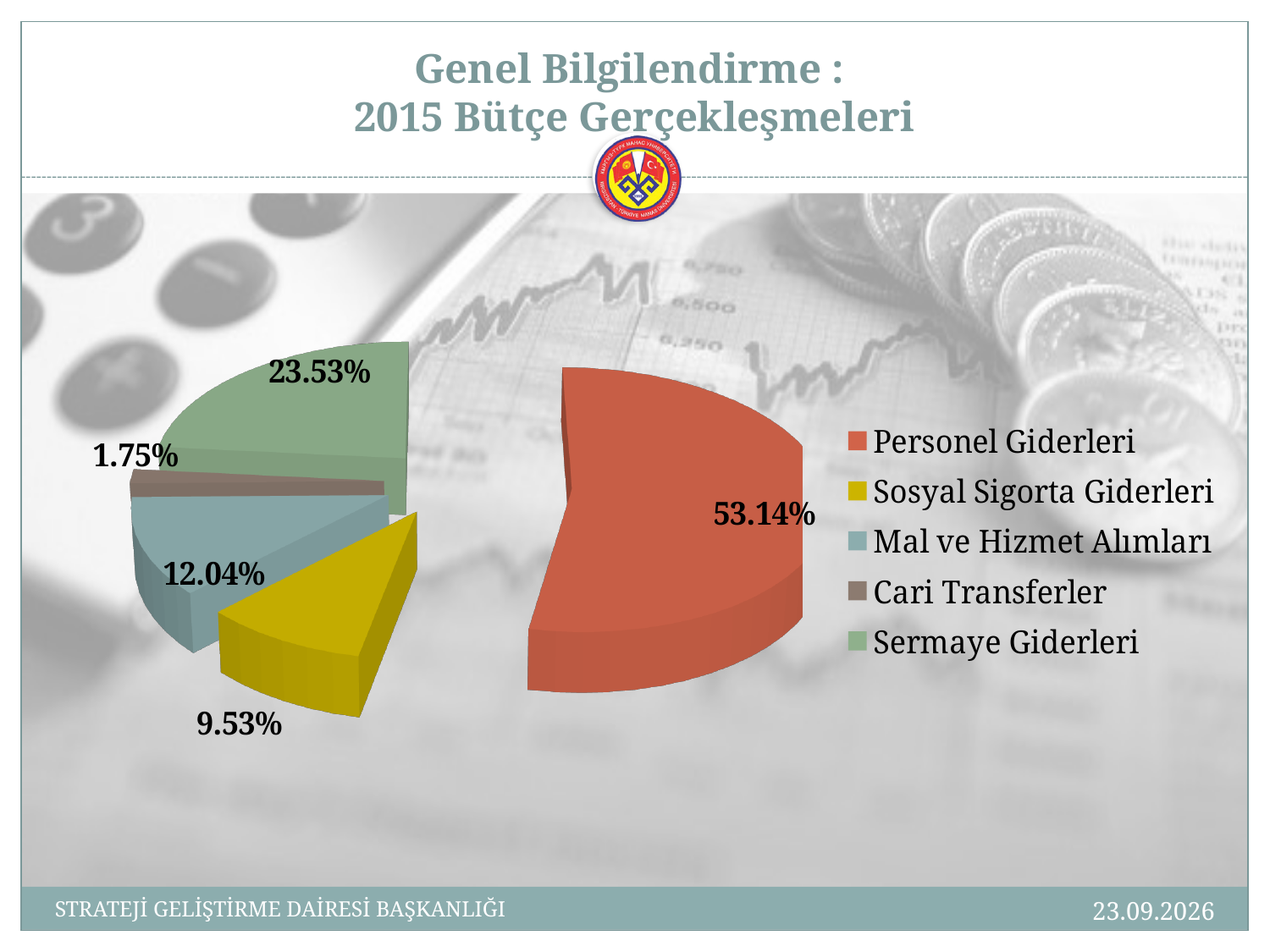
Which category has the smallest share of the pie? Cari Transferler Which is larger, the share for Mal ve Hizmet Alımları or the share for Sosyal Sigorta Giderleri? Mal ve Hizmet Alımları What is the share for Cari Transferler? 1.75% What is the share for Sosyal Sigorta Giderleri? 9.53% What kind of chart is shown on the slide? Pie chart What is the share for Personel Giderleri? 53.14% What is the difference in percentage points between Sermaye Giderleri and Mal ve Hizmet Alımları? 11.49 Which category has the largest share of the pie? Personel Giderleri What is the share for Mal ve Hizmet Alımları? 12.04% How many categories does the legend list? 5 What is the share for Sermaye Giderleri? 23.53% What colour is the slice for Personel Giderleri? Red